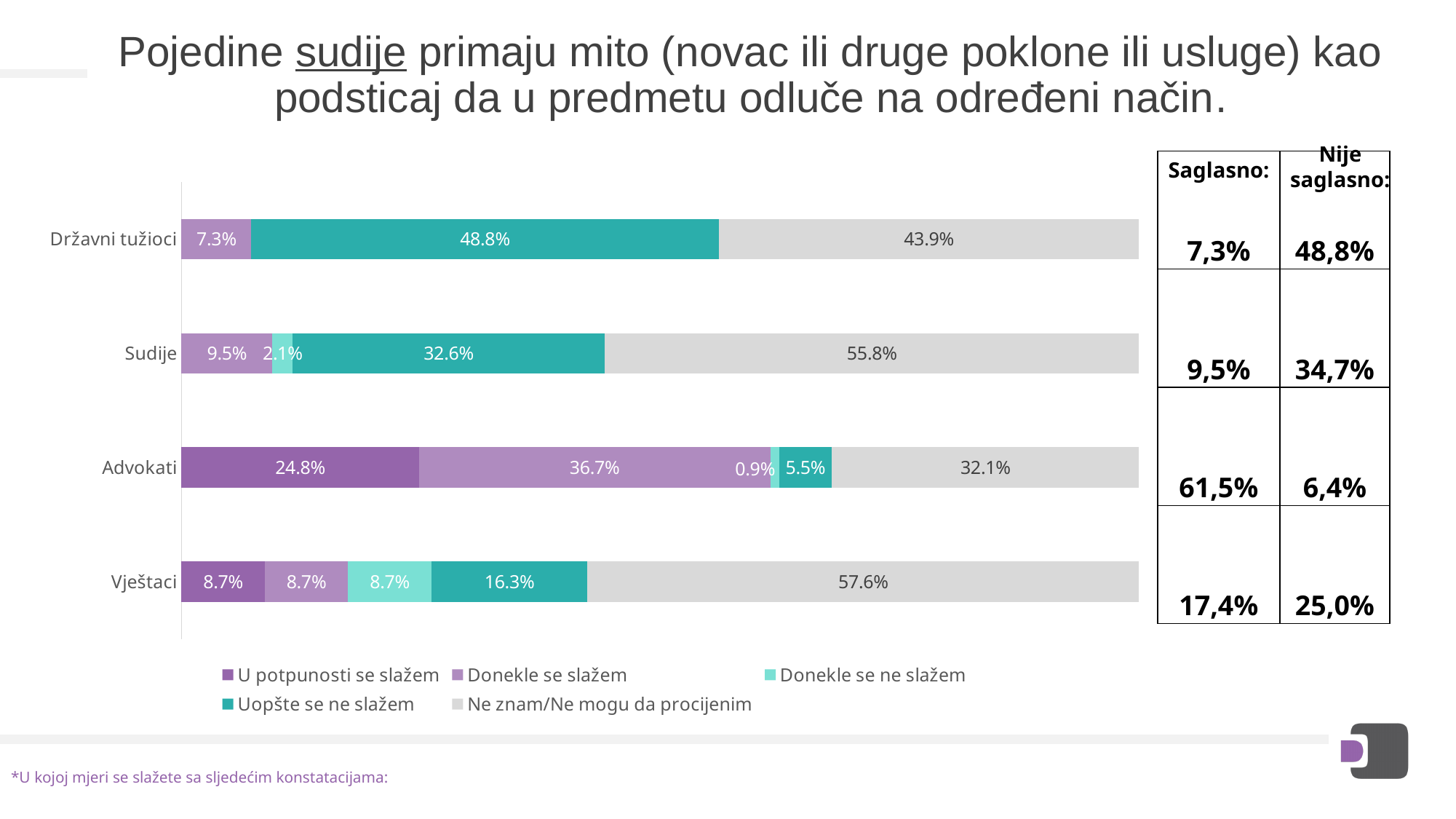
What is the value of 'U potpunosti se slažem' for Advokati? 24.8% Which category has the highest value for 'Ne znam/Ne mogu da procijenim'? Vještaci What kind of chart is shown on the slide? Stacked bar chart How many categories (respondent groups) are shown on the chart? 4 What is the value of 'Donekle se ne slažem' for Vještaci? 8.7% What is the difference between the 'Uopšte se ne slažem' values for Državni tužioci and Sudije? 16.2 percentage points What is the value of 'Ne znam/Ne mogu da procijenim' for Sudije? 55.8% Which is larger: 'Donekle se slažem' for Advokati or 'Donekle se slažem' for Sudije? Advokati Which category has the lowest value for 'Ne znam/Ne mogu da procijenim'? Advokati What is the value of 'Uopšte se ne slažem' for Državni tužioci? 48.8% How many series does the chart legend list? 5 Which legend entry is shown in the lightest grey colour? Ne znam/Ne mogu da procijenim